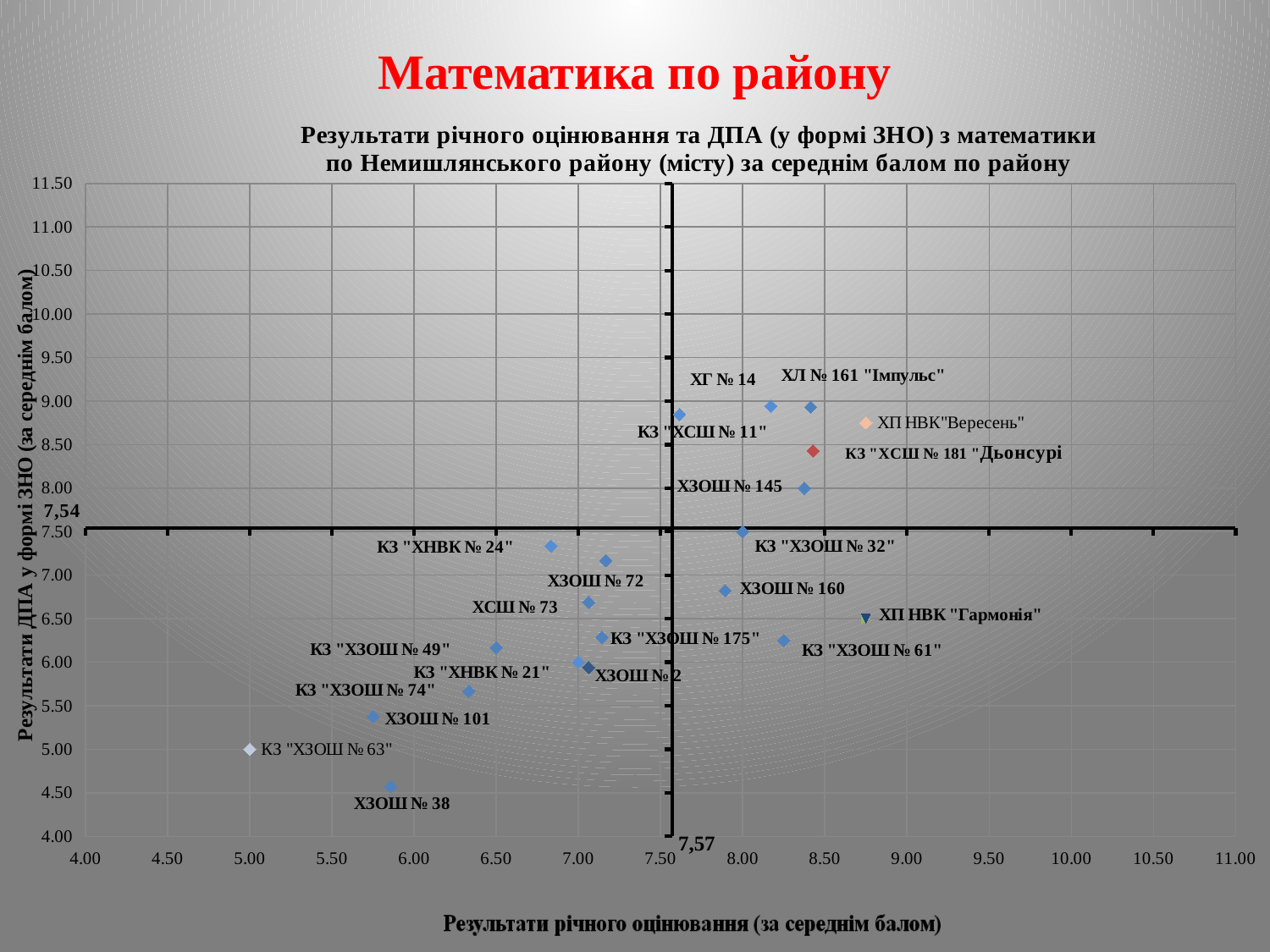
What kind of chart is shown on the slide? scatter chart Is the ДПА result (vertical axis) for ХГ № 14 greater or less than 8.50? greater What is the label of the horizontal axis? Результати річного оцінювання (за середнім балом) Which school has the lowest annual assessment result (horizontal axis)? КЗ "ХЗОШ № 63" Which school has the lowest ДПА result (vertical axis)? ХЗОШ № 38 What value is printed on the horizontal axis where the vertical reference line crosses it? 7,57 Which school has the higher ДПА result (vertical axis): ХЗОШ № 38 or ХГ № 14? ХГ № 14 Is the annual assessment result (horizontal axis) for ХП НВК "Гармонія" greater or less than 8.50? greater Is the annual assessment result (horizontal axis) for КЗ "ХЗОШ № 74" greater or less than 6.50? less What value is printed on the vertical axis where the horizontal reference line crosses it? 7,54 What is the title of the chart? Результати річного оцінювання та ДПА (у формі ЗНО) з математики по Немишлянського району (місту) за середнім балом по району